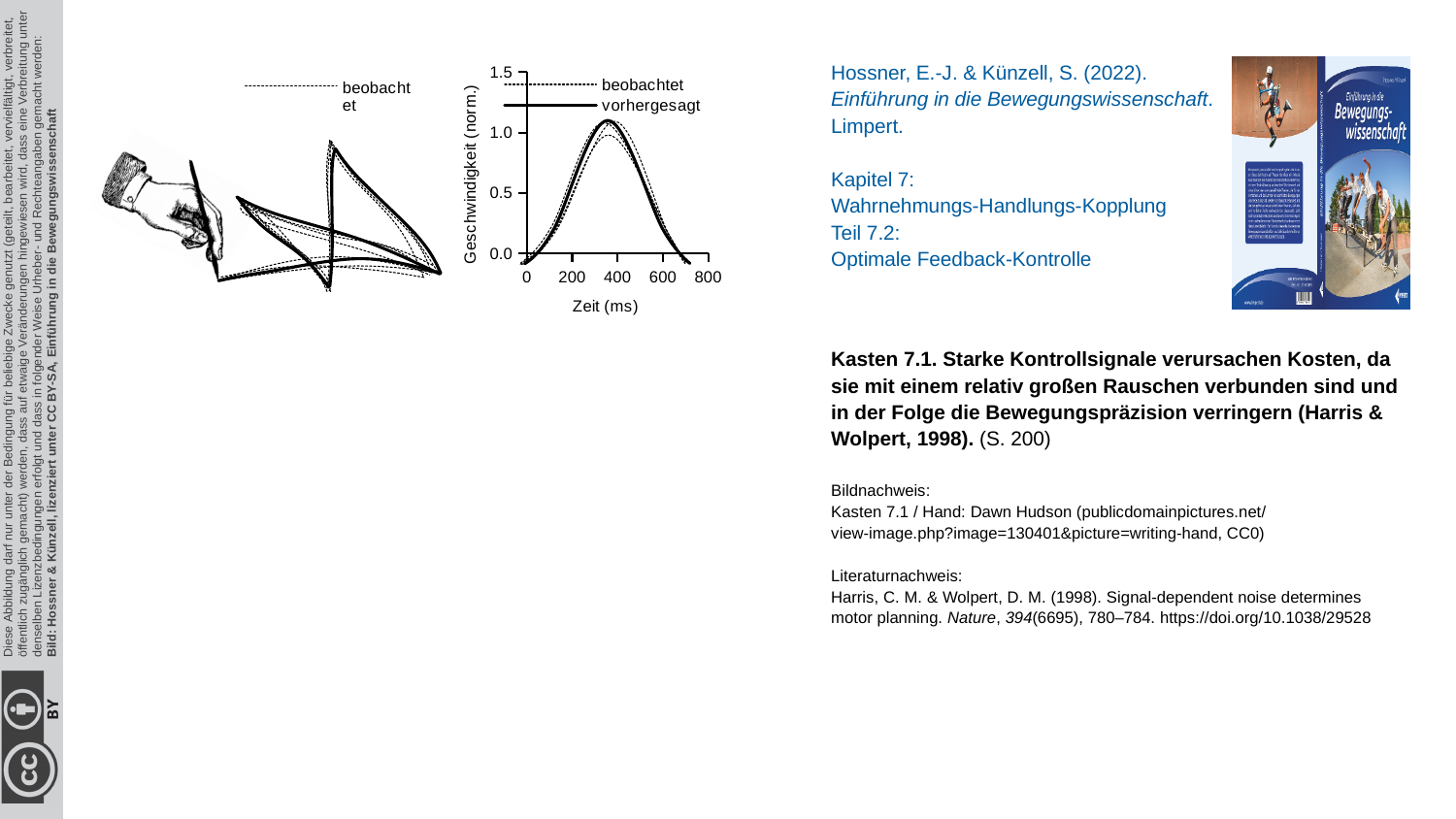
What is the label of the x axis of the velocity-time chart? Zeit (ms) What are the two series named in the legend of the velocity-time chart? beobachtet and vorhergesagt How many series does the legend of the velocity-time chart list? 2 What is the highest tick value shown on the x axis of the velocity-time chart? 800 In the velocity-time chart, is the value of the 'beobachtet' series at 100 ms greater or less than 0.5? less In the velocity-time chart, is the peak value of the 'vorhergesagt' series greater or less than 1.5? less In the velocity-time chart, is the value of the 'vorhergesagt' series at 400 ms greater or less than 0.5? greater In the velocity-time chart, do the values of the 'vorhergesagt' series rise or fall between 0 and 400 ms? rise What kind of chart is the chart with the axes 'Zeit (ms)' and 'Geschwindigkeit (norm.)'? line chart In the velocity-time chart, do the values of the 'vorhergesagt' series rise or fall between 400 and 700 ms? fall What is the highest tick value shown on the y axis of the velocity-time chart? 1.5